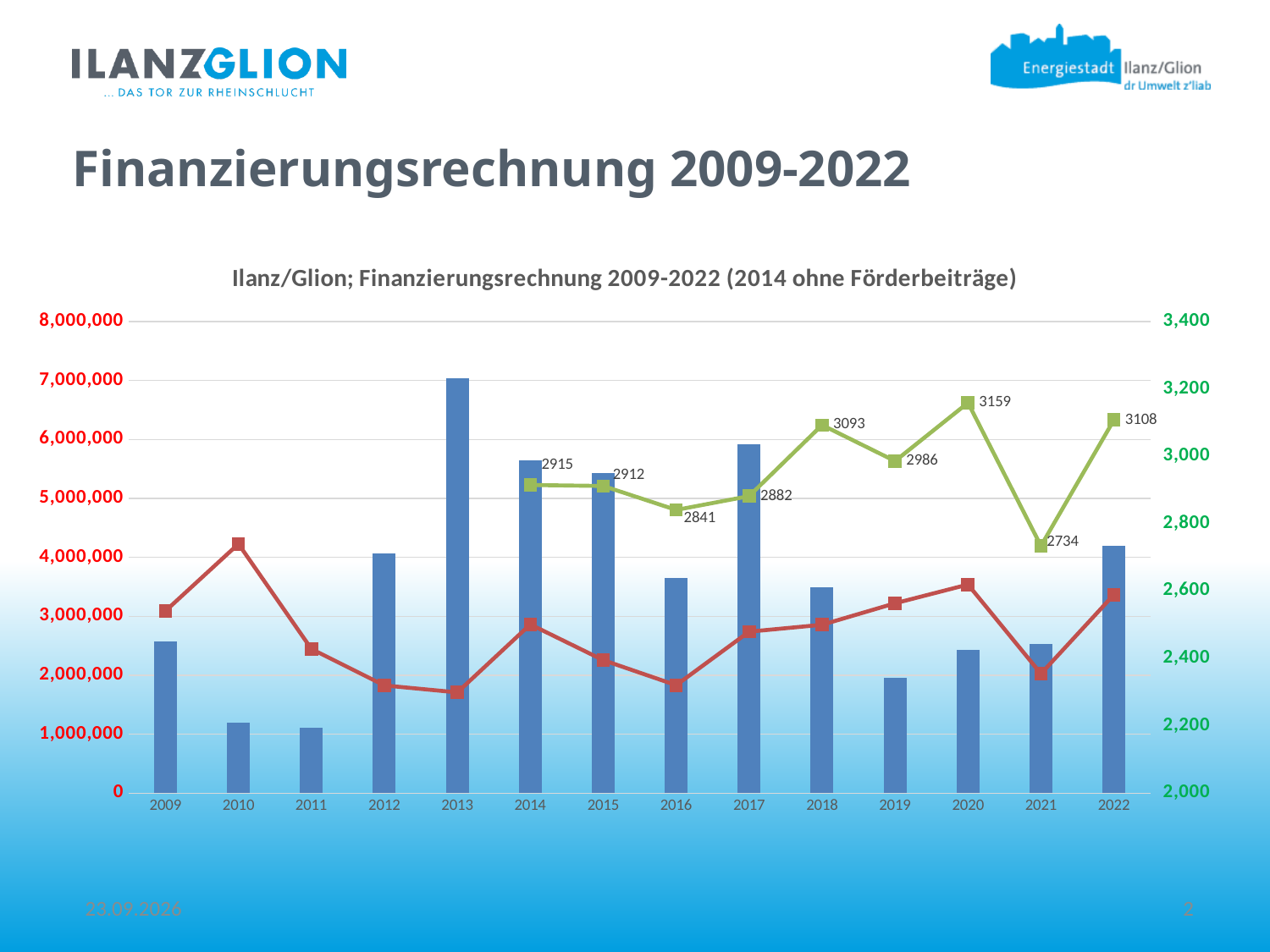
How many years are shown on the x axis? 14 What is the difference between the green line values for 2018 and 2019? 107 Which year has the larger green line value, 2018 or 2022? 2022 What value is labelled on the green line for 2016? 2841 Is the bar for 2013 greater or less than 6,000,000? greater What value is labelled on the green line for 2020? 3159 What is the difference between the green line values for 2020 and 2021? 425 In which year does the green line reach its lowest labelled value? 2021 What is the title of the chart? Ilanz/Glion; Finanzierungsrechnung 2009-2022 (2014 ohne Förderbeiträge) In which year does the green line reach its highest labelled value? 2020 What value is labelled on the green line for 2021? 2734 Which year has the tallest blue bar? 2013